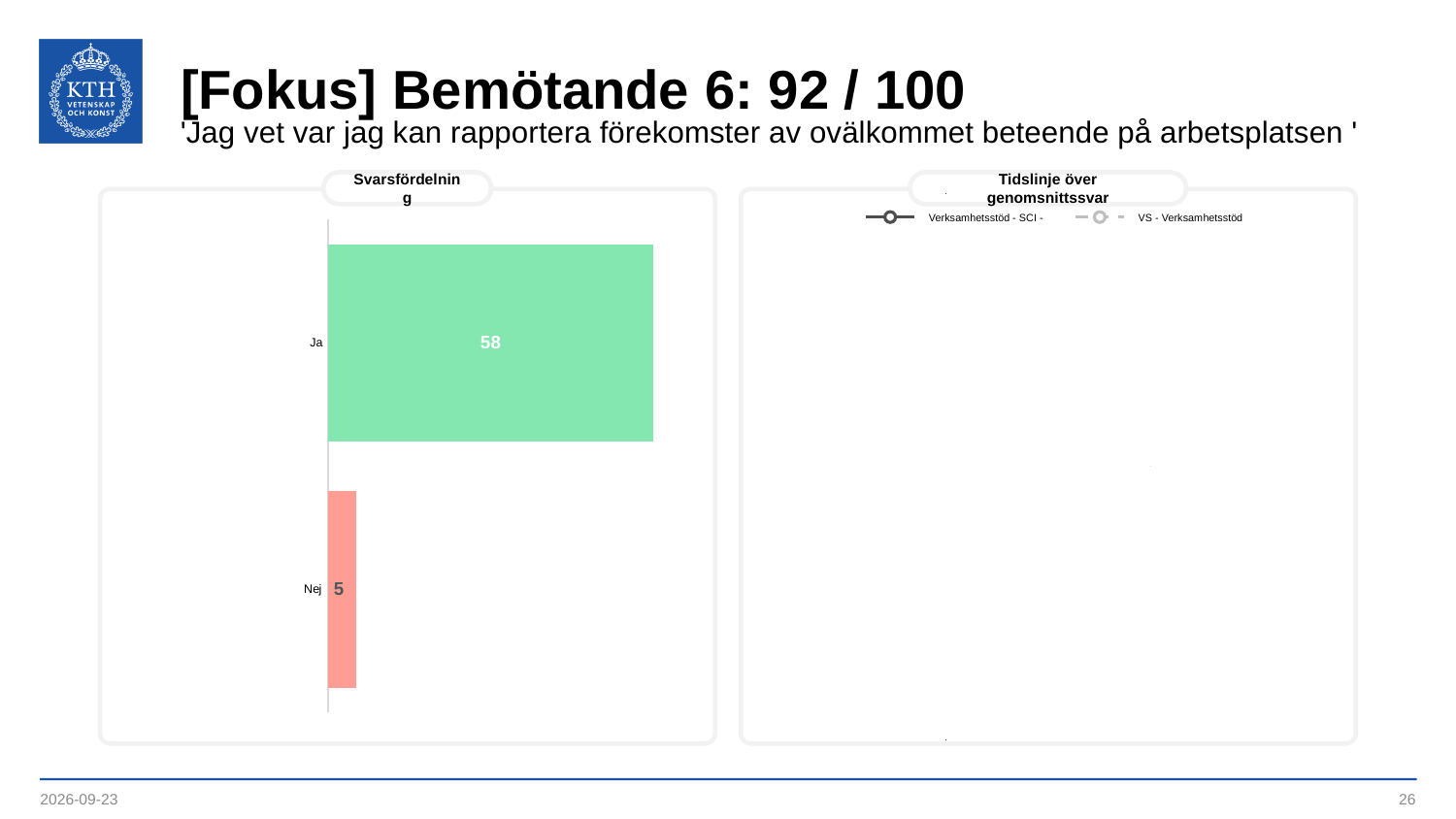
In the Svarsfördelning chart, what is the difference between the values for Ja and Nej? 53 What kind of chart is the Svarsfördelning chart? Bar chart In the Svarsfördelning chart, what is the total of the Ja and Nej values? 63 In the Svarsfördelning chart, which is larger, the value for Ja or the value for Nej? Ja In the Svarsfördelning chart, what is the value for Nej? 5 In the Svarsfördelning chart, what colour is the bar for Ja? Green How many categories are shown in the Svarsfördelning chart? 2 In the Svarsfördelning chart, which category has the lowest value? Nej In the Svarsfördelning chart, what is the value for Ja? 58 In the Svarsfördelning chart, which category has the highest value? Ja How many series does the legend of the Tidslinje över genomsnittssvar chart list? 2